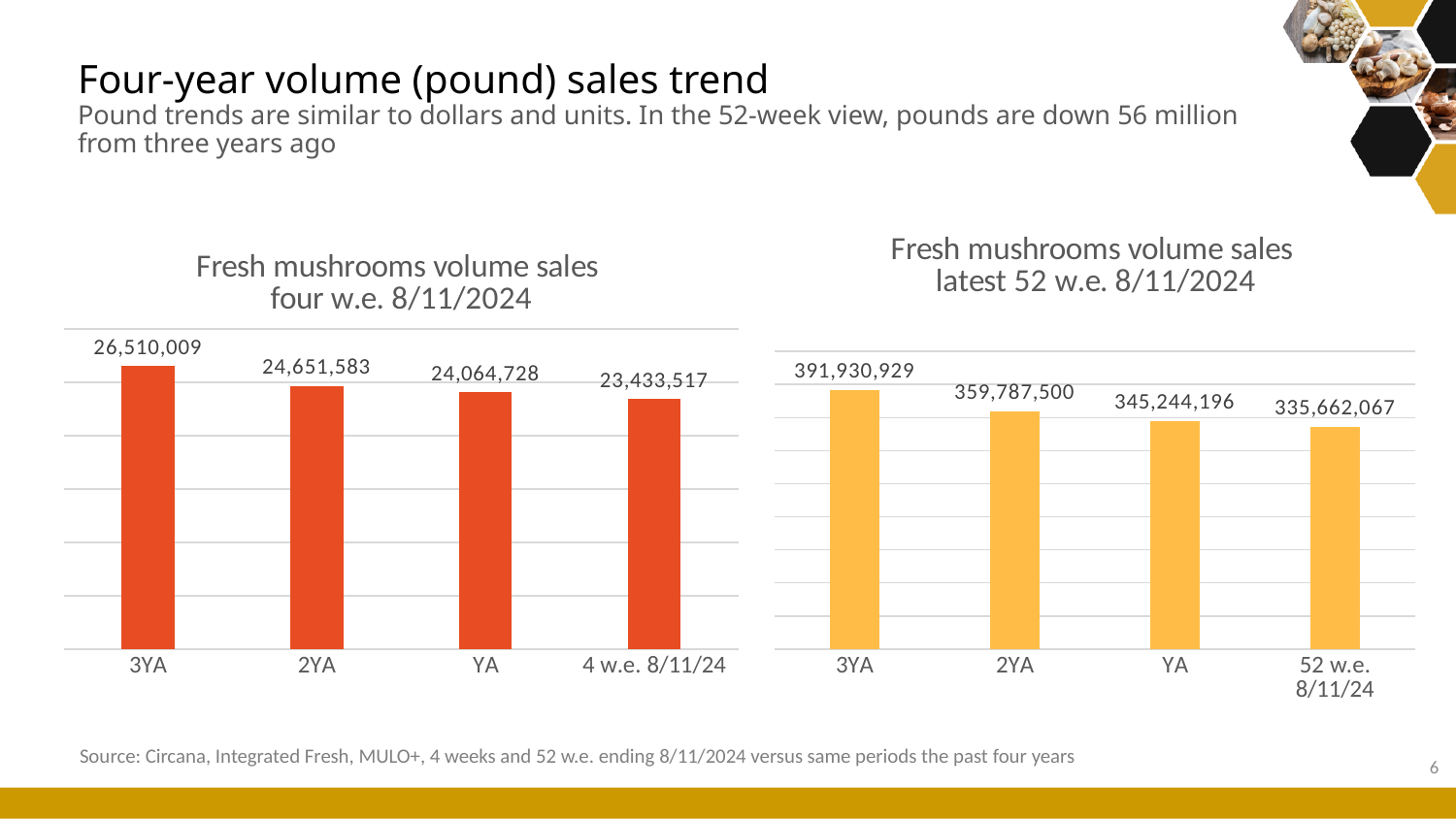
In the 'Fresh mushrooms volume sales four w.e. 8/11/2024' chart, what is the difference between the 3YA value and the 4 w.e. 8/11/24 value? 3,076,492 In the 'Fresh mushrooms volume sales latest 52 w.e. 8/11/2024' chart, what is the value for 2YA? 359,787,500 How many bars are in the 'Fresh mushrooms volume sales four w.e. 8/11/2024' chart? 4 In the 'Fresh mushrooms volume sales four w.e. 8/11/2024' chart, which category has the highest value? 3YA What type of chart is the 'Fresh mushrooms volume sales latest 52 w.e. 8/11/2024' chart? Bar chart In the 'Fresh mushrooms volume sales latest 52 w.e. 8/11/2024' chart, what is the difference between the 3YA value and the 52 w.e. 8/11/24 value? 56,268,862 In the 'Fresh mushrooms volume sales latest 52 w.e. 8/11/2024' chart, which category has the lowest value? 52 w.e. 8/11/24 In the 'Fresh mushrooms volume sales four w.e. 8/11/2024' chart, what is the value for 3YA? 26,510,009 In the 'Fresh mushrooms volume sales latest 52 w.e. 8/11/2024' chart, which is larger, the value for 2YA or the value for YA? 2YA In the 'Fresh mushrooms volume sales four w.e. 8/11/2024' chart, what is the value for 4 w.e. 8/11/24? 23,433,517 In the 'Fresh mushrooms volume sales latest 52 w.e. 8/11/2024' chart, do the values rise or fall from 3YA to 52 w.e. 8/11/24? Fall In the 'Fresh mushrooms volume sales latest 52 w.e. 8/11/2024' chart, what is the value for YA? 345,244,196